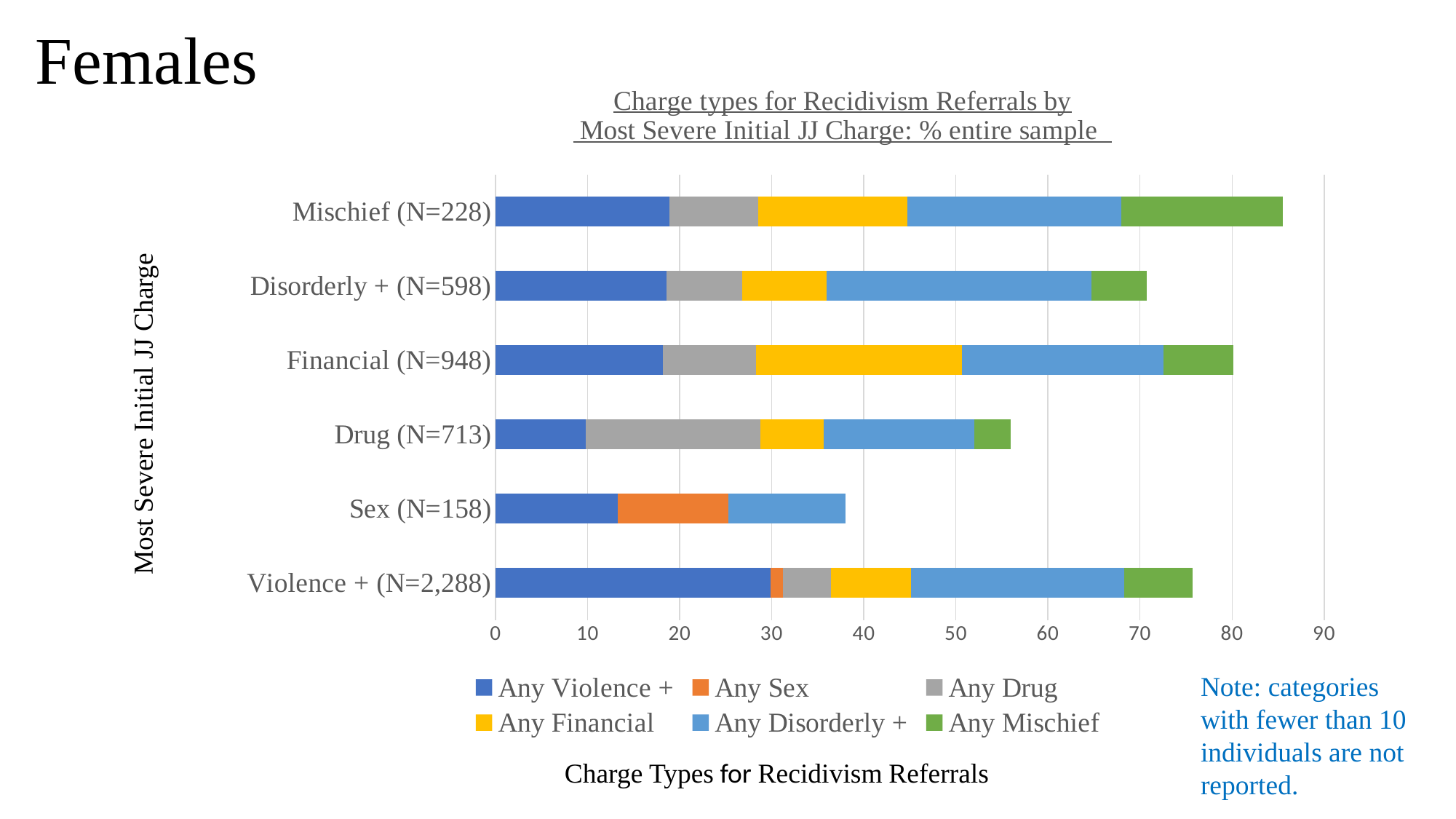
Is the total bar length for Drug (N=713) greater or less than 50? greater Is the total bar length for Mischief (N=228) greater or less than 80? greater How many Most Severe Initial JJ Charge categories are plotted on the chart? 6 How many series does the legend list? 6 What kind of chart is shown on the slide? Stacked bar chart Which series is shown in orange in the legend? Any Sex Is the total bar length for Sex (N=158) greater or less than 40? less Which has the longer total bar, Sex (N=158) or Violence + (N=2,288)? Violence + (N=2,288) Which Most Severe Initial JJ Charge category has the longest total bar? Mischief (N=228) Which has the longer total bar, Financial (N=948) or Drug (N=713)? Financial (N=948) Which Most Severe Initial JJ Charge category has the shortest total bar? Sex (N=158) What is the title of the chart? Charge types for Recidivism Referrals by Most Severe Initial JJ Charge: % entire sample